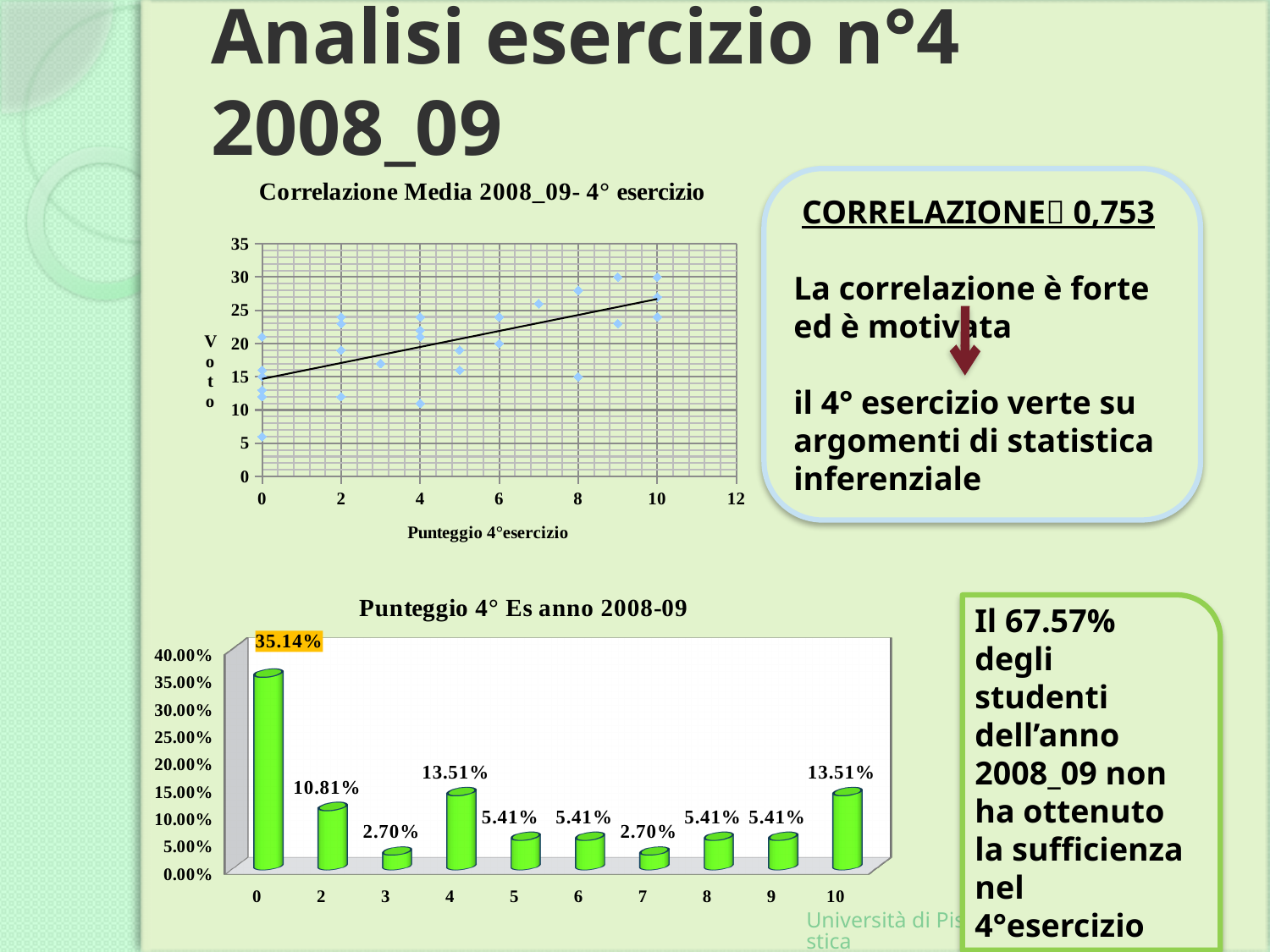
In the chart titled "Punteggio 4° Es anno 2008-09", which is larger, the value for score 4 or the value for score 5? score 4 In the chart titled "Punteggio 4° Es anno 2008-09", what is the combined value for scores 3 and 7? 5.40% In the chart titled "Punteggio 4° Es anno 2008-09", what is the difference between the values for score 0 and score 2? 24.33% In the chart titled "Punteggio 4° Es anno 2008-09", what is the value for score 0? 35.14% In the chart titled "Correlazione Media 2008_09- 4° esercizio", what is the x-axis title? Punteggio 4°esercizio In the chart titled "Correlazione Media 2008_09- 4° esercizio", does the trend line rise or fall as the x-axis score increases? rise What kind of chart is the one titled "Punteggio 4° Es anno 2008-09"? bar chart In the chart titled "Punteggio 4° Es anno 2008-09", which score has the highest percentage? 0 In the chart titled "Punteggio 4° Es anno 2008-09", what is the value for score 4? 13.51% In the chart titled "Punteggio 4° Es anno 2008-09", how many score categories are shown on the x axis? 10 What kind of chart is the one titled "Correlazione Media 2008_09- 4° esercizio"? scatter chart In the chart titled "Punteggio 4° Es anno 2008-09", what is the value for score 2? 10.81%